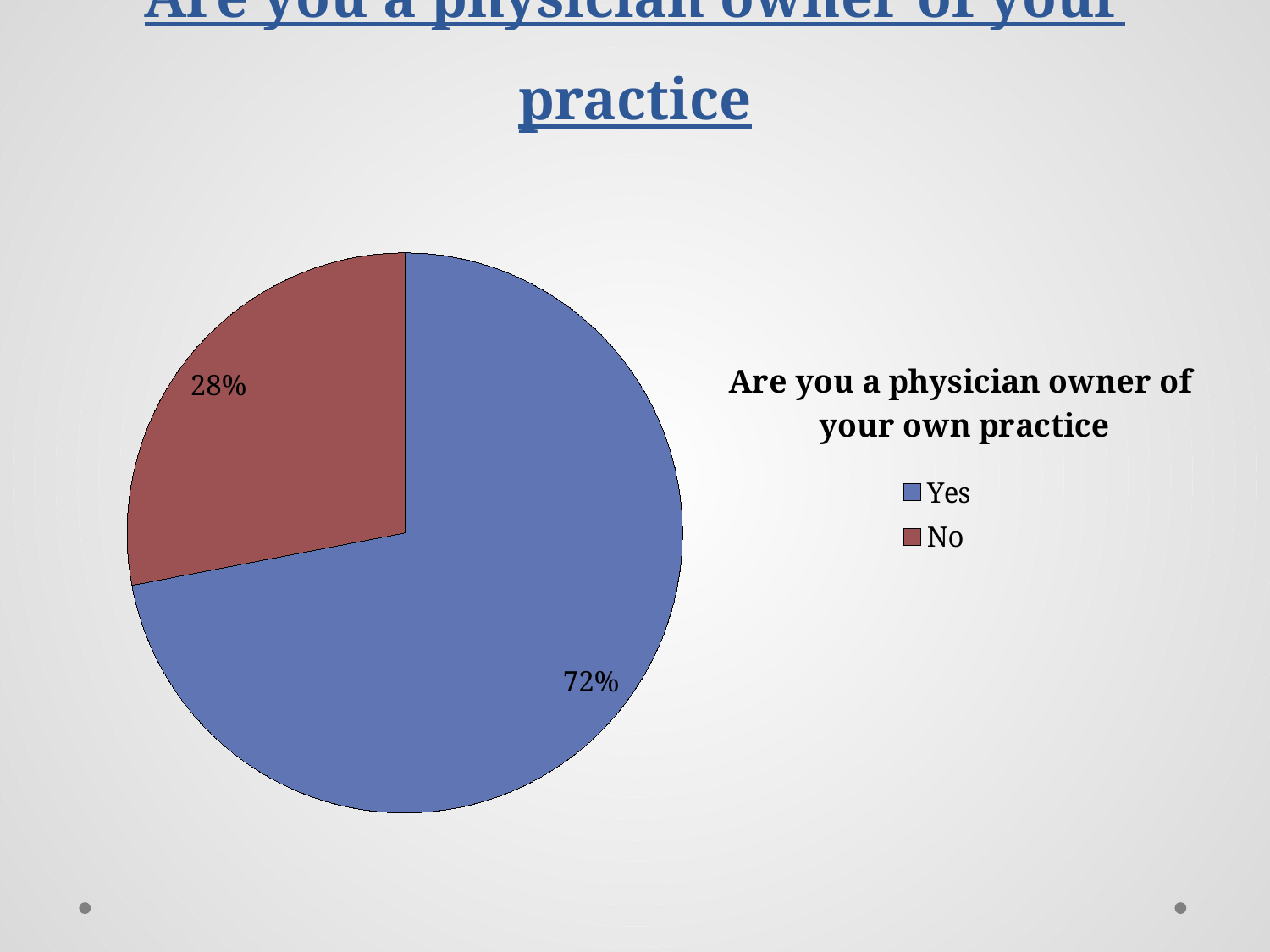
Which response has the largest share of the pie? Yes What colour is the Yes slice? blue What percentage of respondents answered Yes? 72% What is the title of the chart? Are you a physician owner of your own practice What percentage of respondents answered No? 28% What is the difference in percentage points between the Yes and No slices? 44 What kind of chart is shown on the slide? pie chart What share of the pie does the No slice represent? 28% How many slices does the pie chart have? 2 Which response has the smallest share of the pie? No How many entries does the legend list? 2 Which slice is larger, Yes or No? Yes